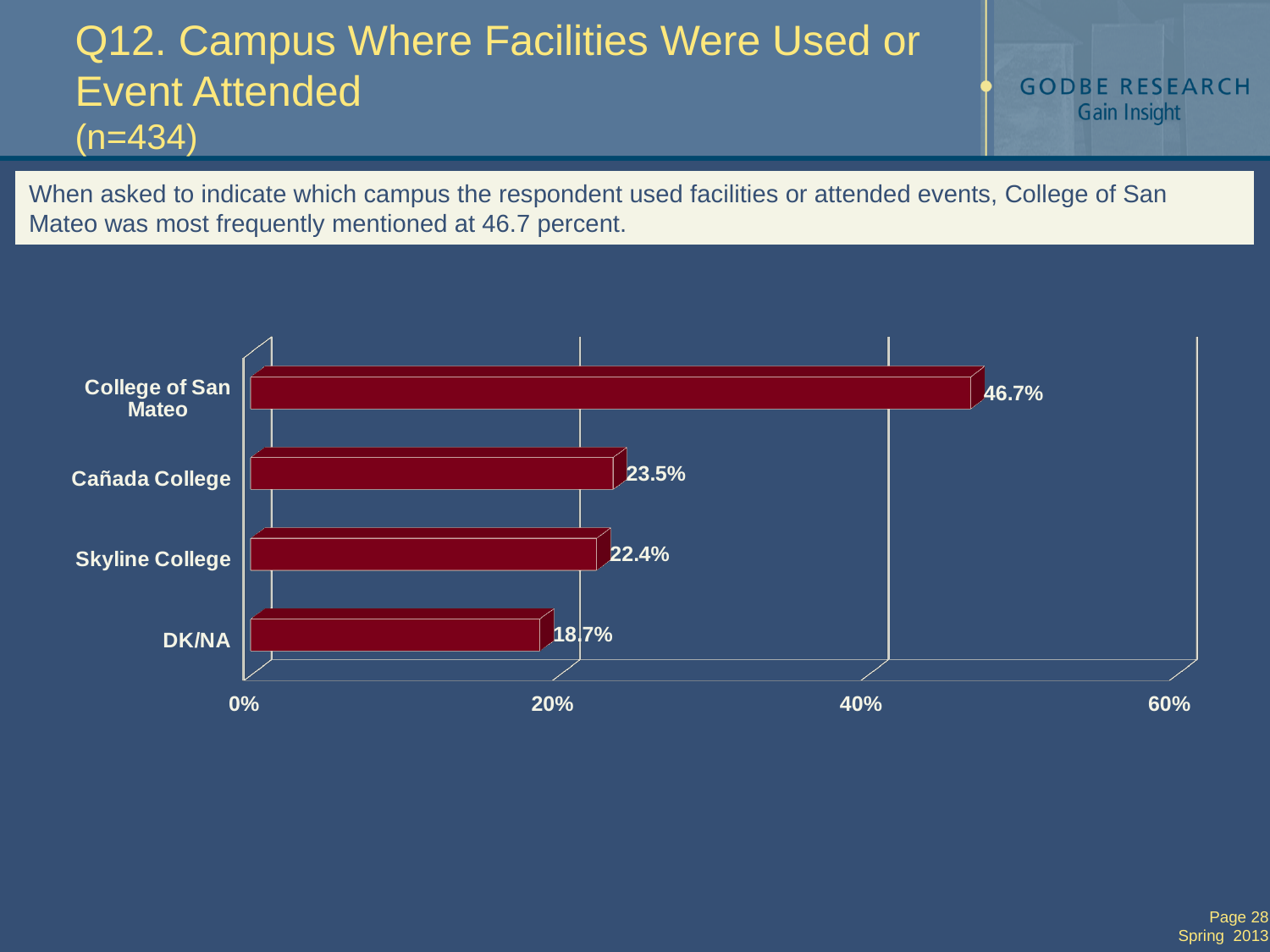
What is the value shown for DK/NA? 18.7% What is the difference in percentage points between College of San Mateo and Cañada College? 23.2 What percentage of respondents mentioned College of San Mateo? 46.7% How many categories are shown in the chart? 4 Which is larger, the value for Skyline College or the value for DK/NA? Skyline College What is the value shown for Cañada College? 23.5% Which category has the lowest percentage? DK/NA Which campus has the highest percentage? College of San Mateo Is the value for College of San Mateo greater or less than 40%? greater What is the difference in percentage points between Cañada College and Skyline College? 1.1 What kind of chart is shown on the slide? Bar chart What is the value shown for Skyline College? 22.4%